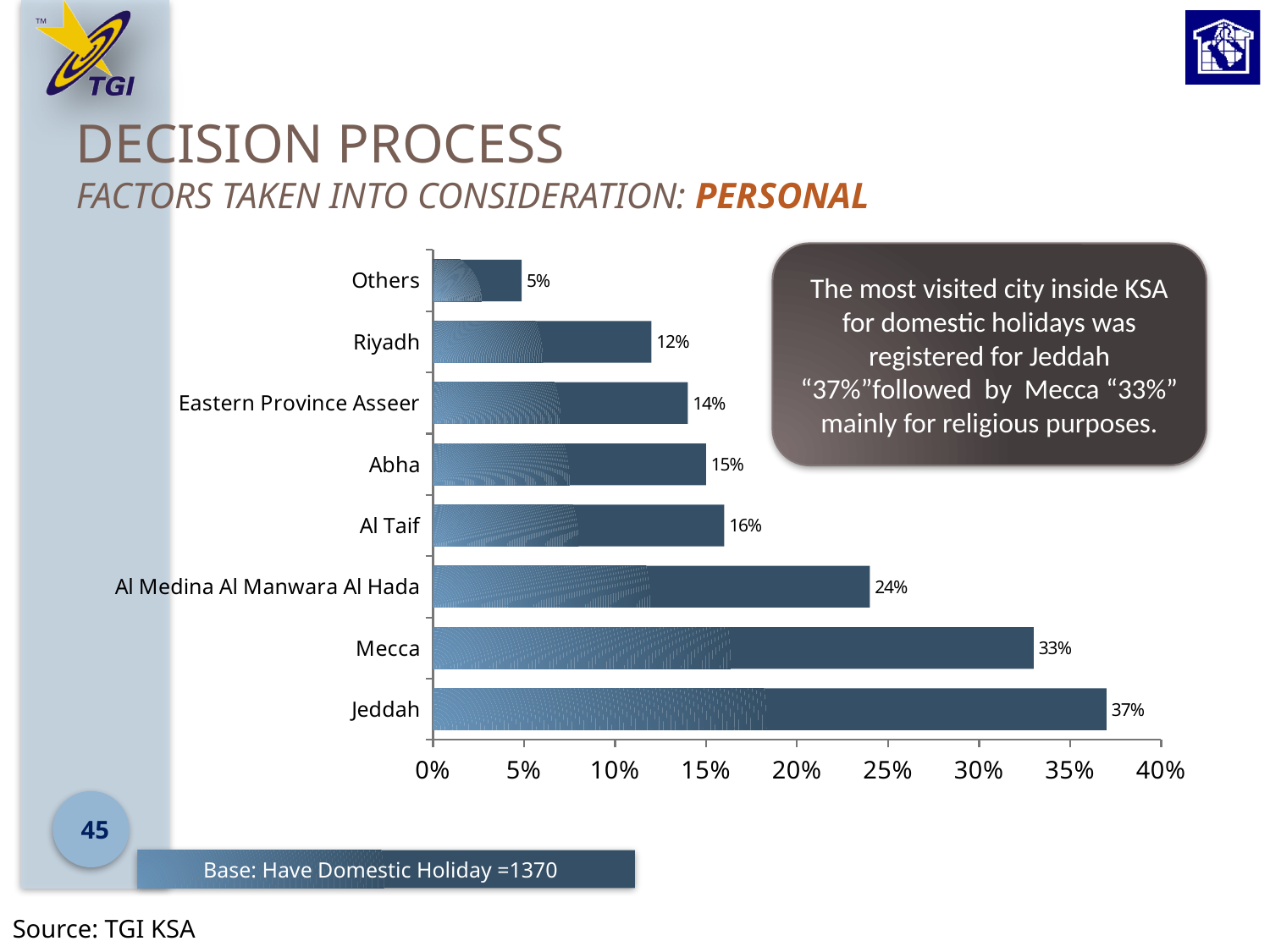
Which category has the lowest value? Others Is the value for Al Medina Al Manwara Al Hada greater or less than 20%? greater What is the difference between the values for Al Taif and Abha? 1% What is the value for Jeddah? 37% What kind of chart is shown on the slide? Bar chart What is the value for Mecca? 33% What is the difference between the values for Jeddah and Mecca? 4% Which category has the highest value? Jeddah What is the value for Al Medina Al Manwara Al Hada? 24% Which is larger, the value for Eastern Province Asseer or the value for Riyadh? Eastern Province Asseer How many categories are shown in the chart? 8 What is the value for Riyadh? 12%